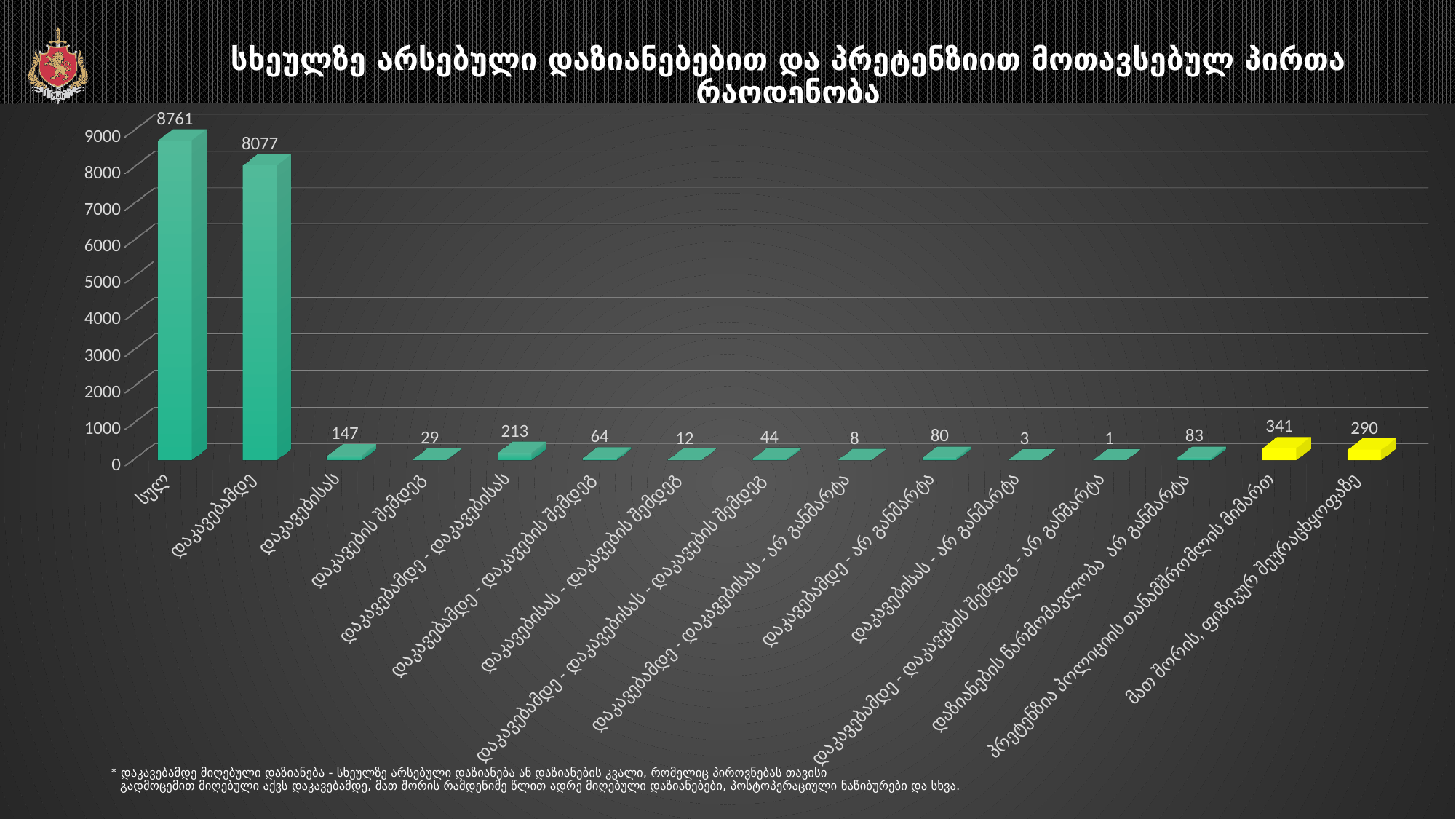
What is the value for the category "დაკავების შემდეგ"? 29 Which is larger, the value for "დაკავებისას" or the value for "დაკავებამდე - დაკავებისას"? დაკავებამდე - დაკავებისას What is the value for the category "მათ შორის, ფიზიკურ შეურაცხყოფაზე"? 290 What is the value for the category "სულ"? 8761 Which category has the highest value? სულ Which category has the lowest value? დაკავებამდე - დაკავების შემდეგ - არ განმარტა What is the value for the category "პრეტენზია პოლიციის თანამშრომლის მიმართ"? 341 What is the value for the category "დაკავებამდე"? 8077 What colour are the two rightmost bars? yellow What kind of chart is shown on the slide? bar chart How many categories are shown on the x axis? 15 What is the difference between the values for "სულ" and "დაკავებამდე"? 684